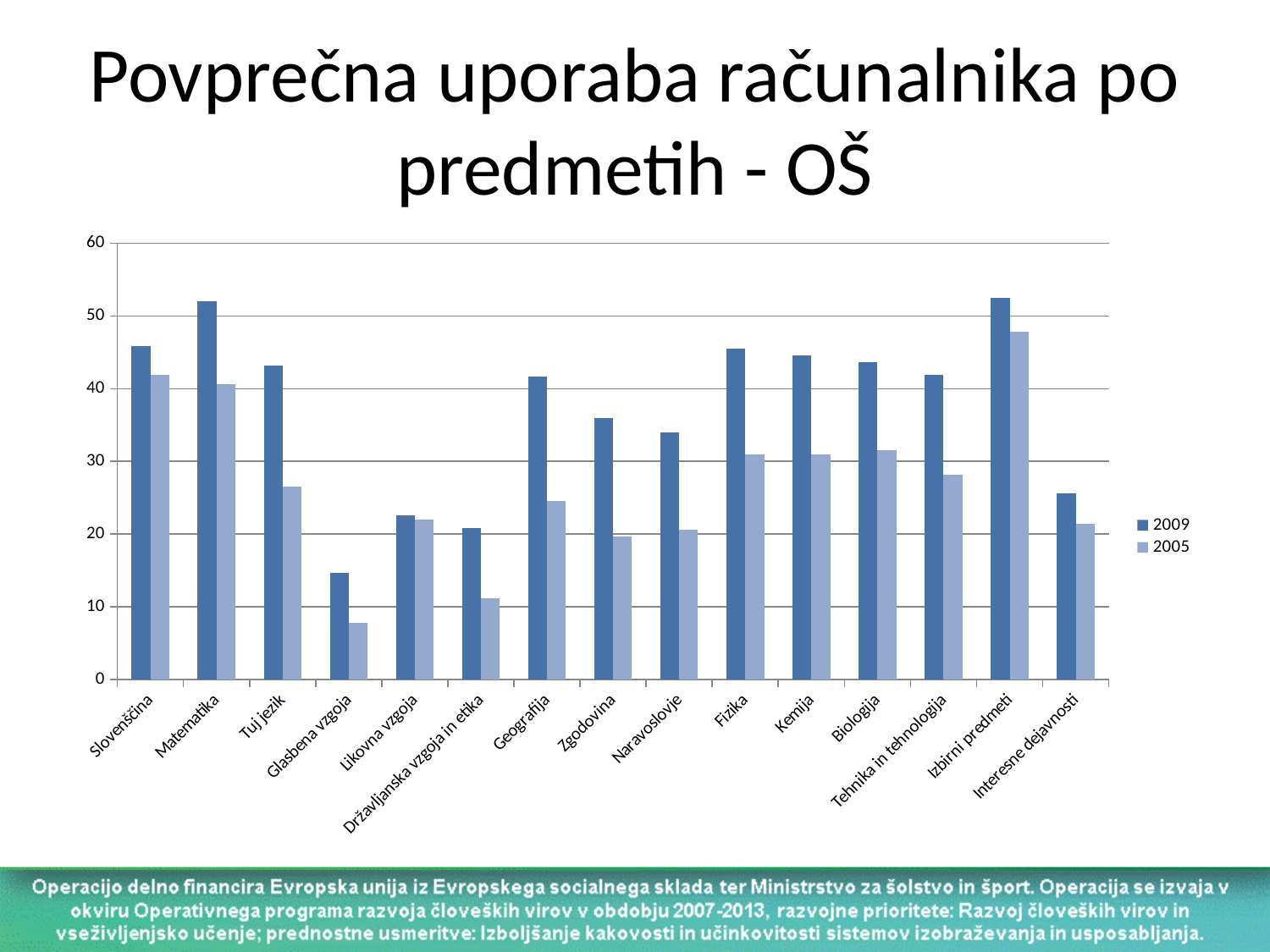
Which subject has the lowest value for 2009? Glasbena vzgoja For 2009, which is larger: Matematika or Tuj jezik? Matematika Is the 2009 value for Zgodovina greater or less than 40? less For Državljanska vzgoja in etika, which year has the larger value, 2009 or 2005? 2009 Which subject has the lowest value for 2005? Glasbena vzgoja Is the 2005 value for Tehnika in tehnologija greater or less than 30? less How many subject categories are shown on the x axis? 15 Is the 2009 value for Slovenščina greater or less than 40? greater How many series does the legend list? 2 What kind of chart is shown on the slide? bar chart Which subject has the highest value for 2005? Izbirni predmeti